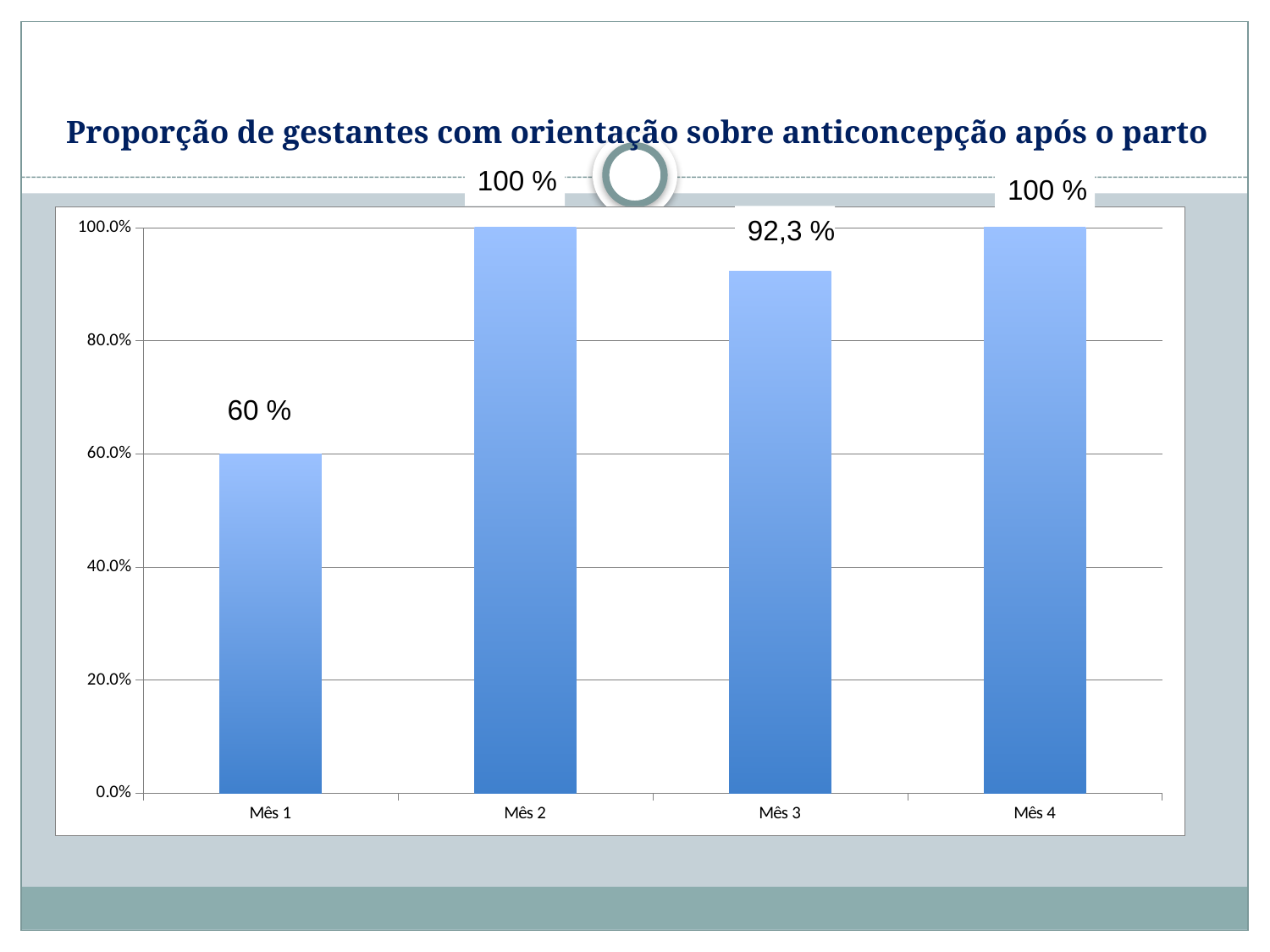
What is the value for Mês 3? 92,3 % What is the value for Mês 1? 60 % How many months are shown on the x axis? 4 Is the value for Mês 3 greater or less than 80.0%? greater What is the title of the chart? Proporção de gestantes com orientação sobre anticoncepção após o parto What is the value for Mês 2? 100 % Does the value rise or fall from Mês 1 to Mês 2? rise Which is larger, the value for Mês 3 or the value for Mês 1? Mês 3 What is the difference between the values for Mês 2 and Mês 1? 40 % What is the difference between the values for Mês 4 and Mês 3? 7,7 % Which month has the lowest value? Mês 1 What kind of chart is shown on the slide? bar chart